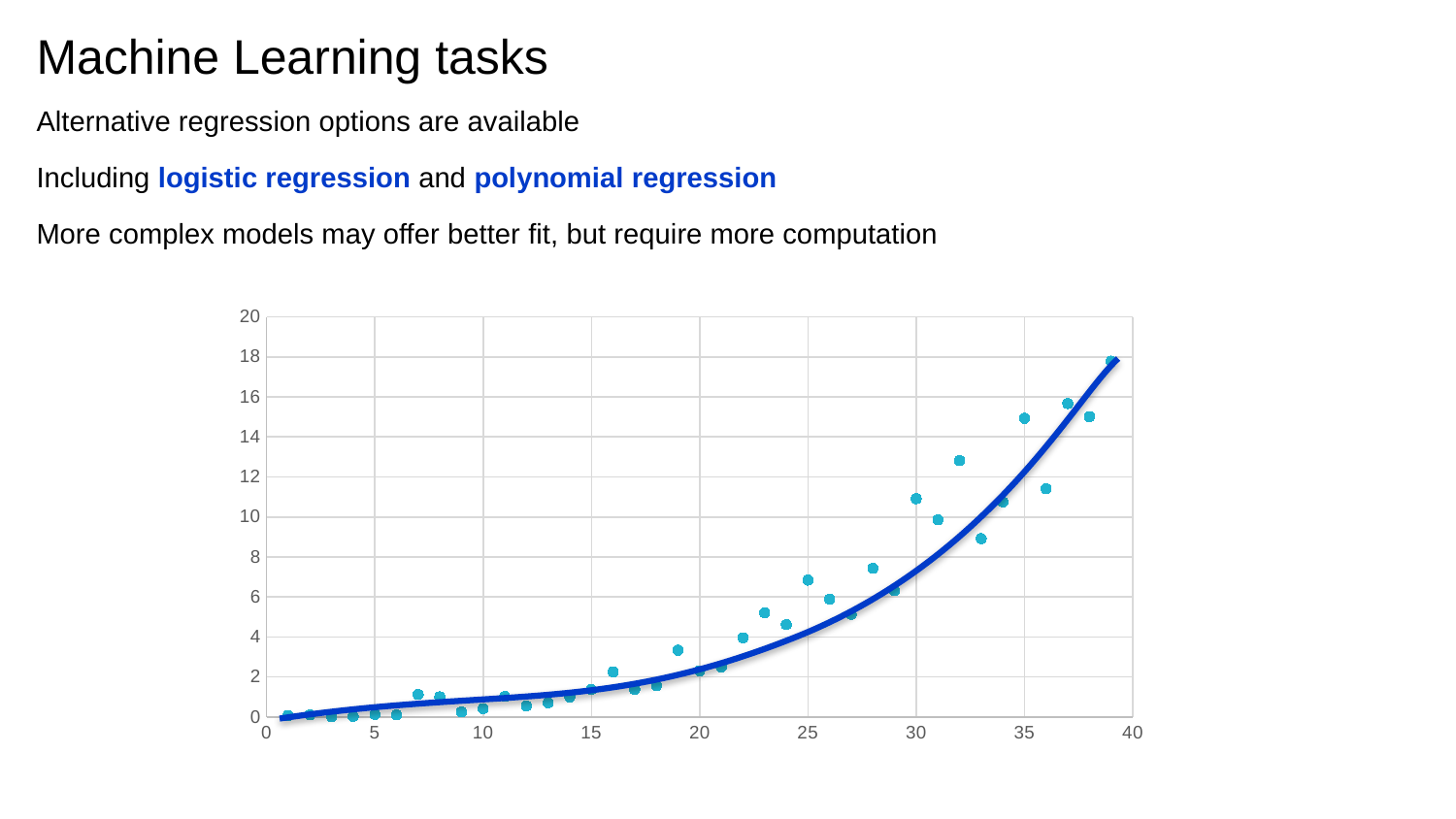
Is the value of the point at x = 35 greater or less than 12? greater Is the value of the point at x = 25 greater or less than 4? greater Do the plotted values generally rise or fall as x increases along the x axis? rise What colour is the fitted curve drawn through the points? dark blue What kind of chart is shown on the slide? scatter chart Is the value of the point at x = 36 greater or less than 14? less Which point has the larger value, the one at x = 35 or the one at x = 36? x = 35 What is the highest value shown on the y axis? 20 At which x value does the highest plotted point occur? 39